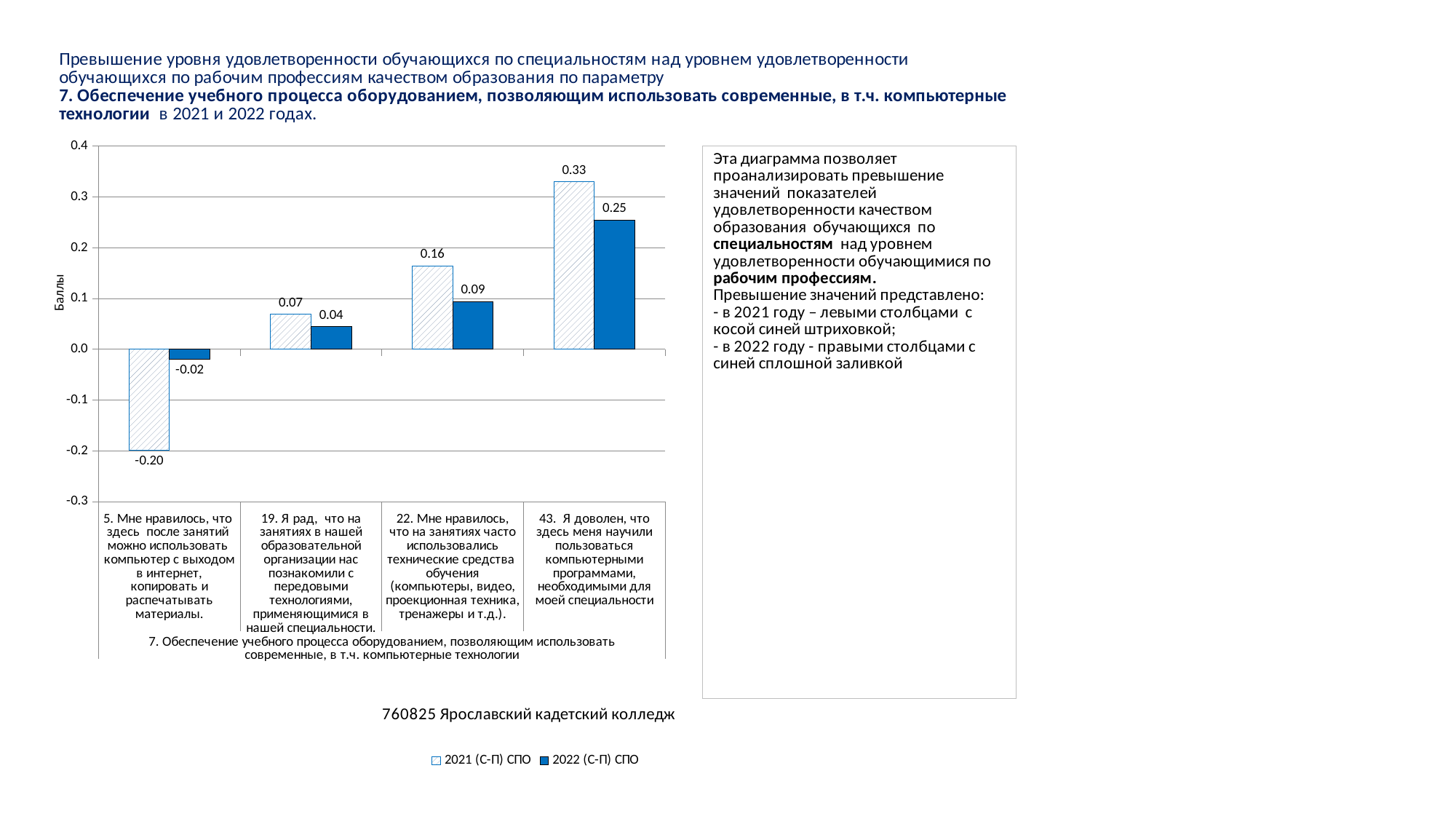
What is the 2021 (С-П) СПО value for category 43 (Я доволен, что здесь меня научили пользоваться компьютерными программами)? 0.33 Which category has the lowest 2021 (С-П) СПО value? 5. Мне нравилось, что здесь после занятий можно использовать компьютер с выходом в интернет, копировать и распечатывать материалы. What type of chart is shown on the slide? bar chart What is the 2021 (С-П) СПО value for category 22 (Мне нравилось, что на занятиях часто использовались технические средства обучения)? 0.16 What is the label of the vertical axis of the chart? Баллы How many series does the chart legend list? 2 Do the 2022 (С-П) СПО values rise or fall moving from category 5 to category 43 along the x axis? rise What is the difference between the 2021 and 2022 (С-П) СПО values for category 43? 0.08 Which category has the highest 2022 (С-П) СПО value? 43. Я доволен, что здесь меня научили пользоваться компьютерными программами, необходимыми для моей специальности For category 19 (Я рад, что на занятиях в нашей образовательной организации нас познакомили с передовыми технологиями), which series has the larger value, 2021 (С-П) СПО or 2022 (С-П) СПО? 2021 (С-П) СПО What is the 2022 (С-П) СПО value for category 5 (Мне нравилось, что здесь после занятий можно использовать компьютер с выходом в интернет)? -0.02 How many categories (questions) are shown on the x axis of the chart? 4